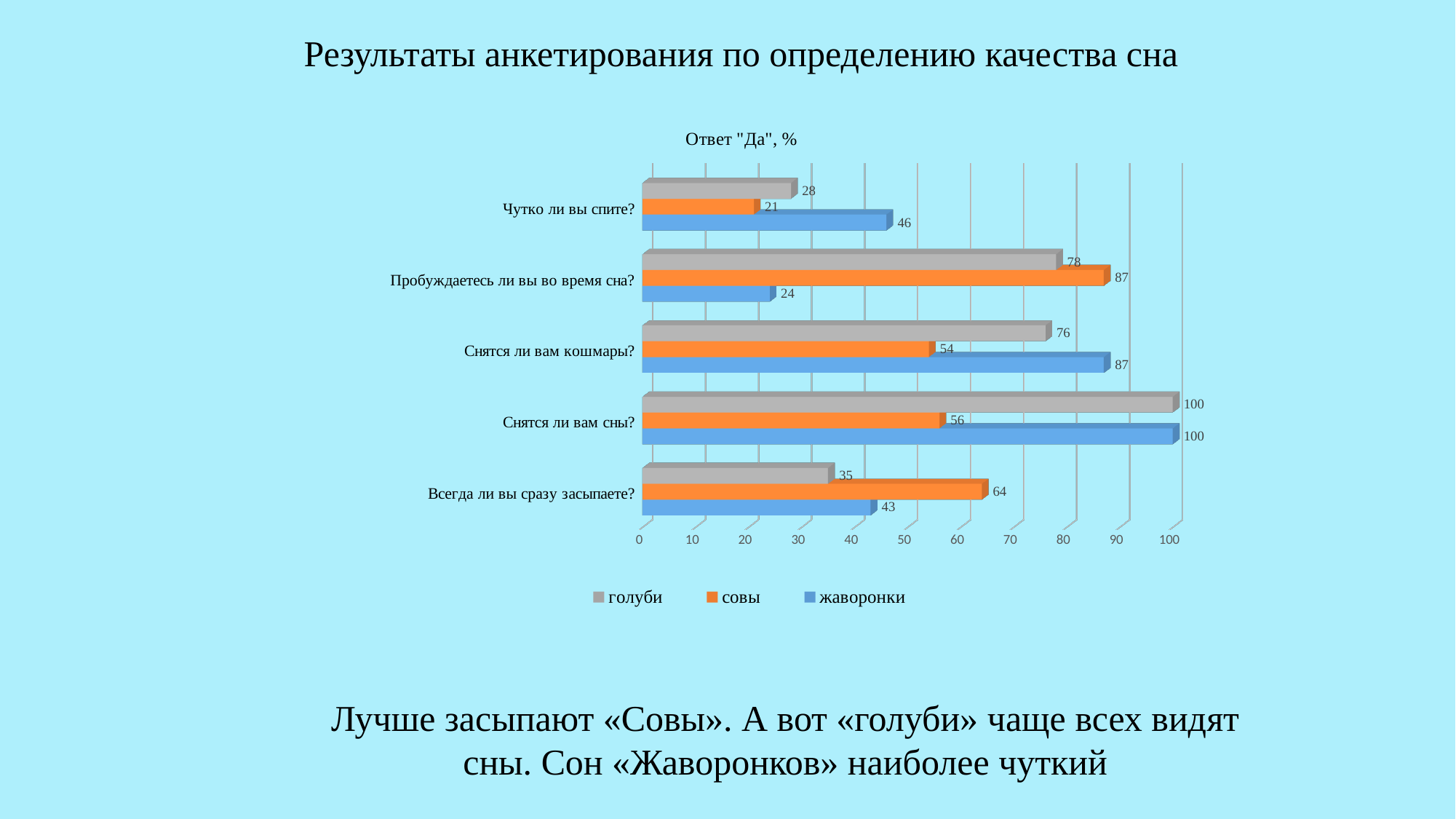
What kind of chart is shown on the slide? Bar chart What is the value for "жаворонки" on "Чутко ли вы спите?"? 46 What is the value for "голуби" on "Пробуждаетесь ли вы во время сна?"? 78 What is the value for "совы" on "Всегда ли вы сразу засыпаете?"? 64 What is the difference between the "совы" and "жаворонки" values for "Пробуждаетесь ли вы во время сна?"? 63 Which series has the lowest value for "Чутко ли вы спите?"? совы Which series has the highest value for "Снятся ли вам кошмары?"? жаворонки How many series does the legend list? 3 How many questions (categories) are shown on the chart? 5 What is the title of the chart? Ответ "Да", % For "Всегда ли вы сразу засыпаете?", which is larger: the value for "голуби" or for "жаворонки"? жаворонки Which series is shown in orange? совы